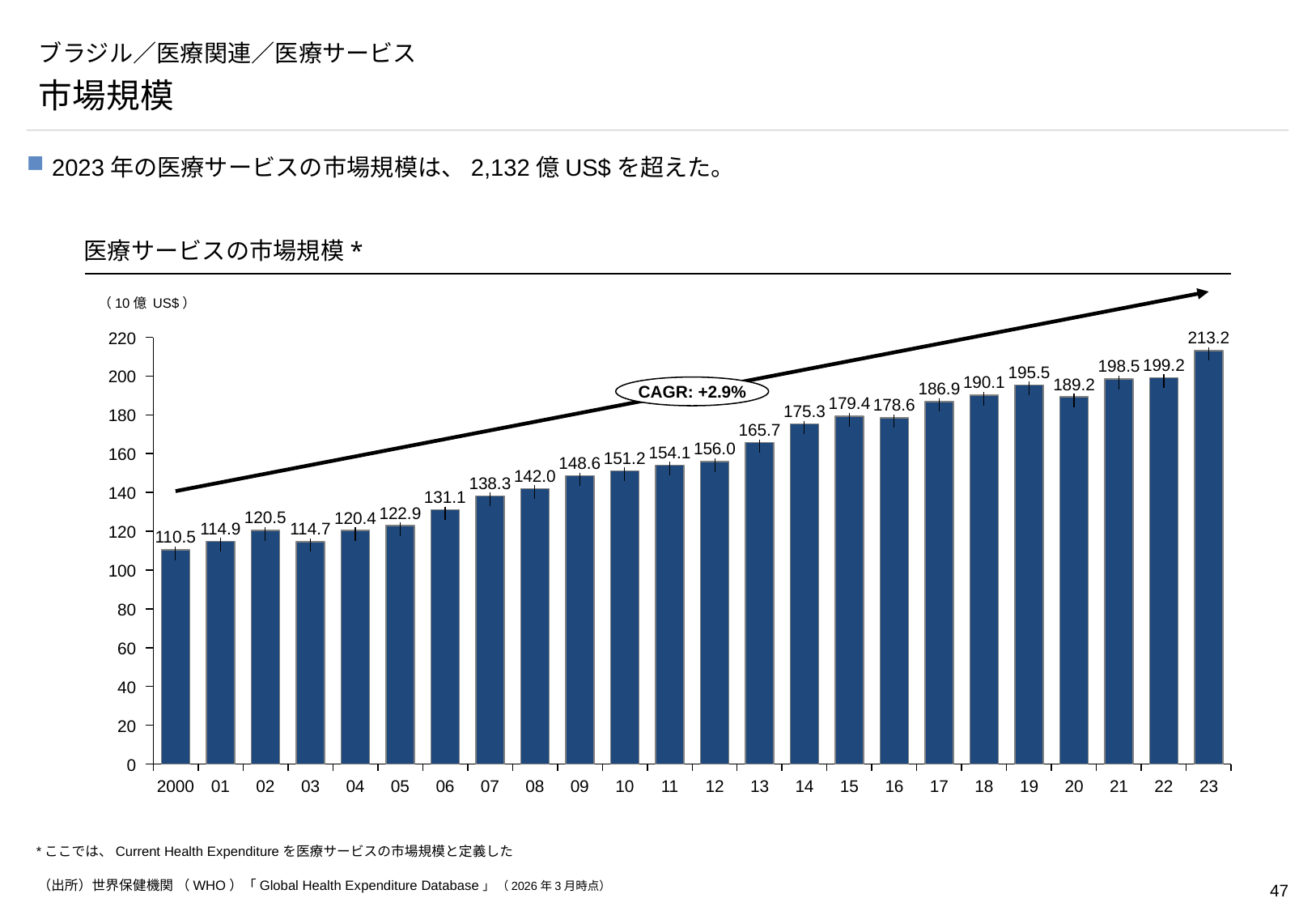
How many years (bars) are plotted in the chart? 24 Which year has the lowest bar in the chart? 2000 Do the values generally rise or fall from 2000 to 2023? rise Which year has the highest bar in the chart? 23 (2023) What is the difference between the 2023 value and the 2000 value? 102.7 What is the market size value shown for 2023? 213.2 What CAGR is annotated on the chart? +2.9% What is the market size value shown for 2000? 110.5 What is the value shown for 2013? 165.7 Is the value for 2020 greater or less than the value for 2019? less Which is larger, the value for 2015 or the value for 2016? 2015 (179.4) What kind of chart is used to show the market size? bar chart